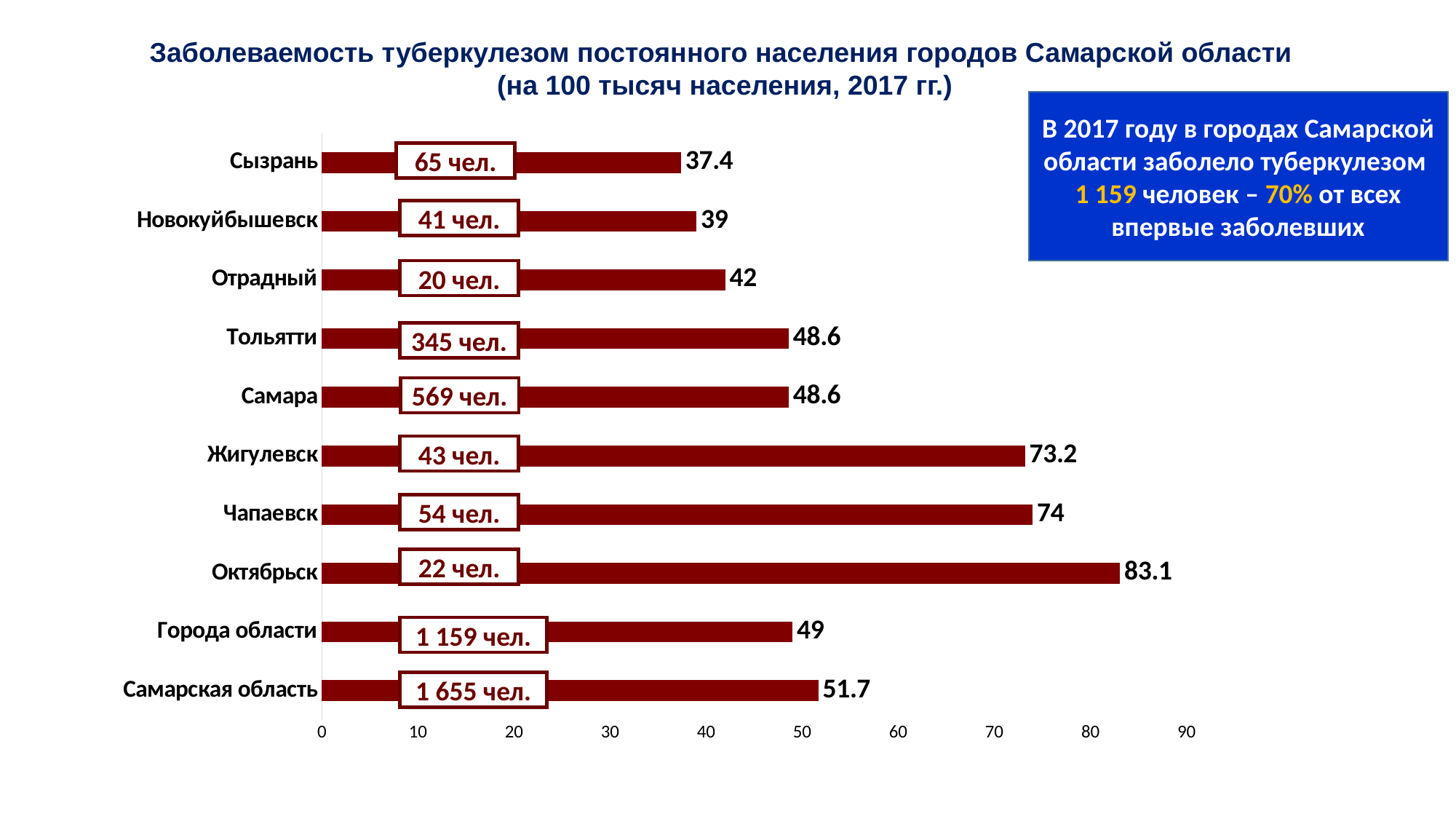
Which has a higher value: Самарская область or Города области? Самарская область According to the text box on the slide, how many people in the cities of Samara region fell ill with tuberculosis in 2017? 1 159 How many categories (bars) are shown on the chart? 10 What kind of chart is shown on the slide? bar chart What is the difference between the values for Октябрьск and Сызрань? 45.7 Is the value for Октябрьск greater or less than 80? greater What is the value shown for Сызрань? 37.4 How many people (чел.) are shown in the label on the bar for Самара? 569 чел. What is the value shown for Самарская область? 51.7 Which category has the lowest incidence rate on the chart? Сызрань Which category has the highest incidence rate on the chart? Октябрьск What is the tuberculosis incidence rate per 100 thousand population shown for Октябрьск? 83.1